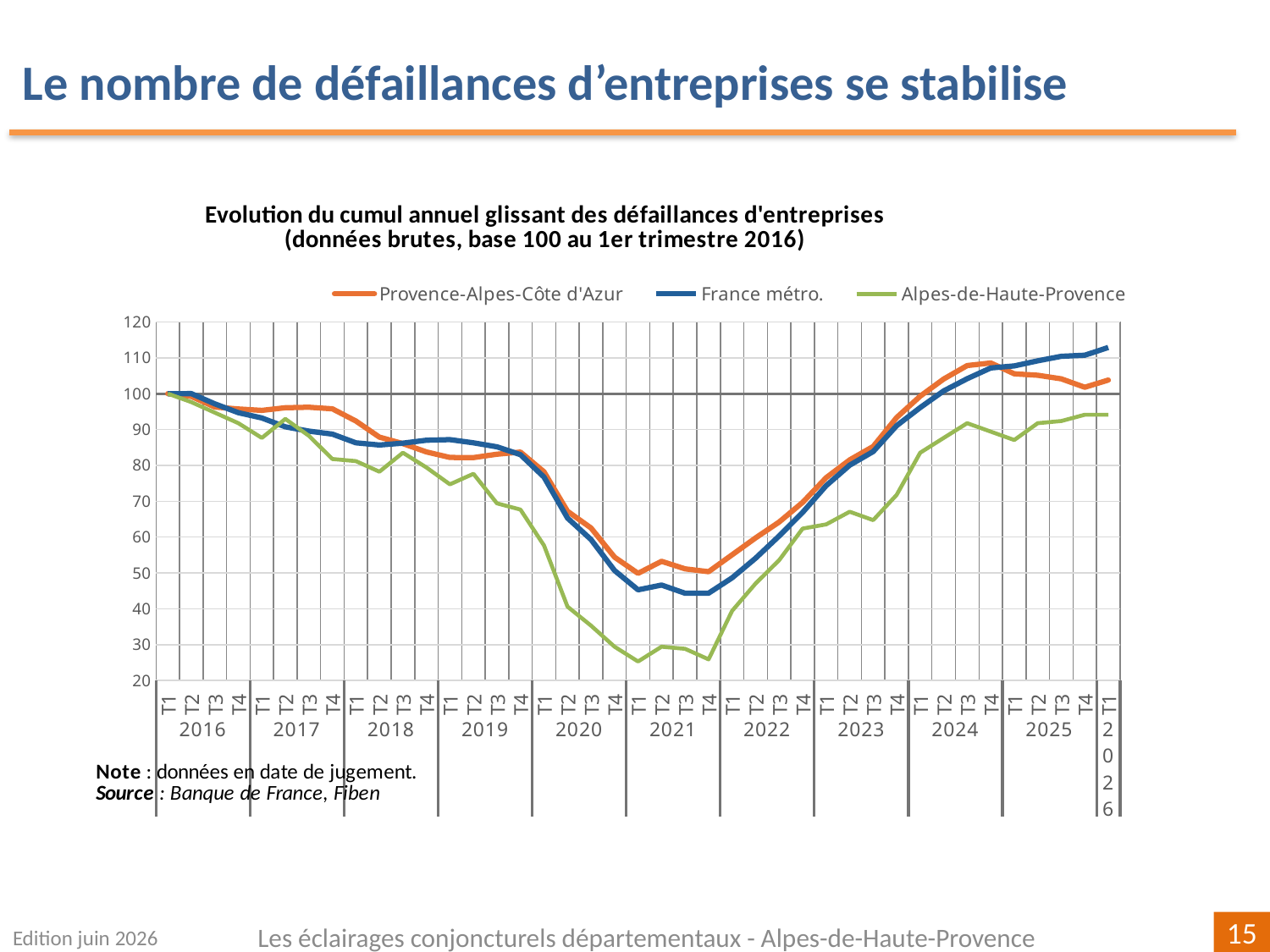
What is the value of the France métro. series at T1 2016? 100 Does the Alpes-de-Haute-Provence series rise or fall between T1 2016 and T4 2021? fall Is the value for Alpes-de-Haute-Provence at T1 2021 greater or less than 30? less What kind of chart is shown on the slide? line chart At T1 2026, which series is higher: Provence-Alpes-Côte d'Azur or France métro.? France métro. How many years are labelled on the x axis? 11 Is the value for Alpes-de-Haute-Provence at T1 2026 greater or less than 100? less Is the value for France métro. at T1 2026 greater or less than 110? greater Which series has the lowest value at T1 2021? Alpes-de-Haute-Provence How many series does the legend list? 3 Which colour is used for the Alpes-de-Haute-Provence series? green